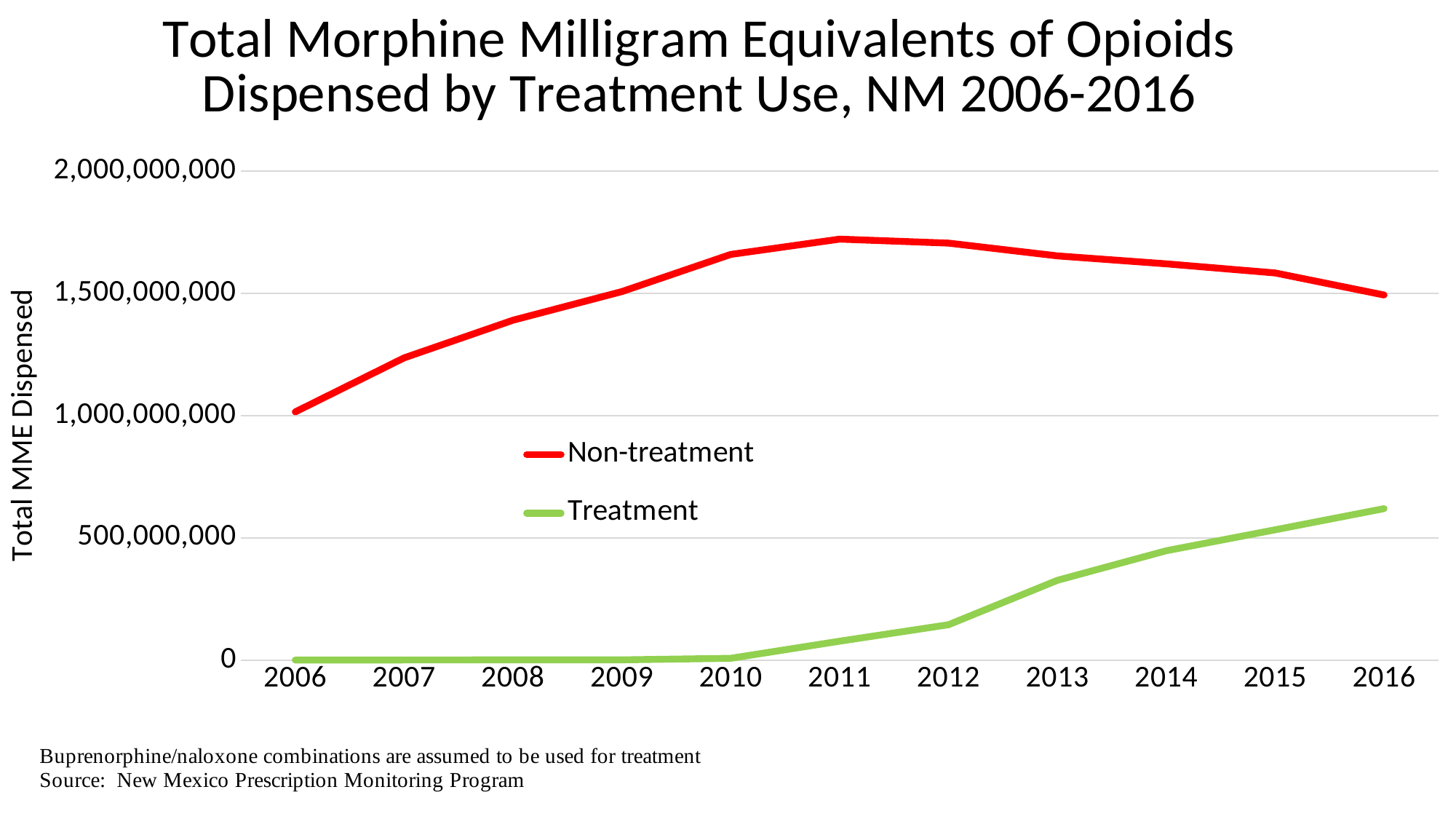
How many series does the legend list? 2 Is the Treatment value for 2012 greater or less than 500,000,000? less Is the Treatment value for 2016 greater or less than 500,000,000? greater In which year is the Non-treatment series lowest? 2006 What kind of chart is shown on the slide? line chart How many years are plotted along the x axis? 11 In which year is the Treatment series highest? 2016 Is the Non-treatment value for 2006 greater or less than 1,500,000,000? less Does the Treatment series rise or fall from 2010 to 2016? rise What colour is the Treatment line in the legend? green In 2016, which series has the larger value, Non-treatment or Treatment? Non-treatment